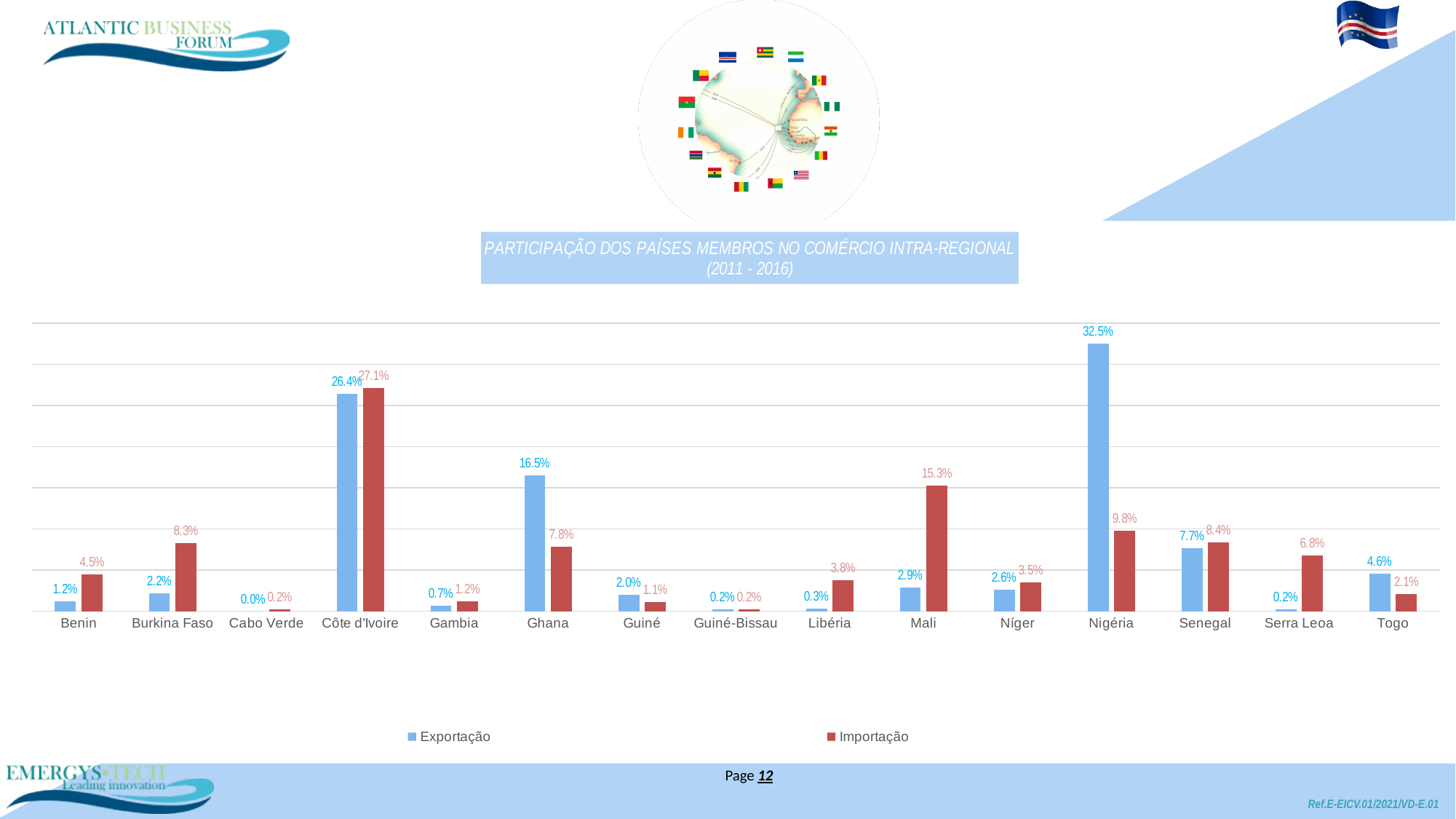
What is the Exportação value for Ghana? 16.5% How many countries are shown on the x axis? 15 Which country has the highest Exportação value? Nigéria What is the difference between the Importação and Exportação values for Mali? 12.4% Which country has the highest Importação value? Côte d'Ivoire Which is larger for Ghana, Exportação or Importação? Exportação Which country has the lowest Exportação value? Cabo Verde What type of chart is shown on the slide? Bar chart How many series does the legend list? 2 What is the Exportação value for Nigéria? 32.5% What is the Importação value for Mali? 15.3% What is the Importação value for Serra Leoa? 6.8%